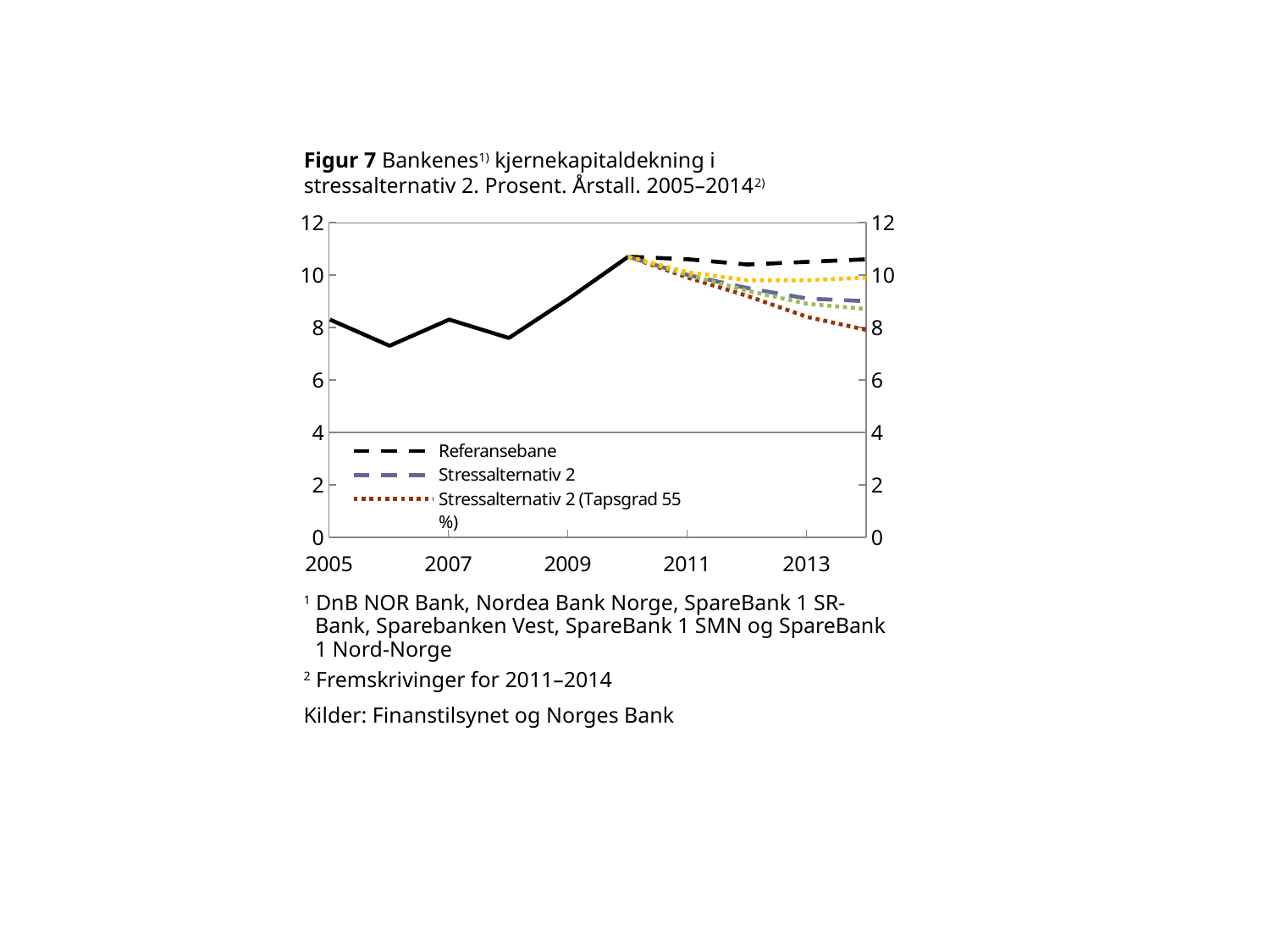
Which series has the lowest value in 2014? Stressalternativ 2 (Tapsgrad 55 %) In 2014, which is larger: Referansebane or Stressalternativ 2? Referansebane What is the highest value shown on the vertical axis? 12 Which series has the highest value in 2014? Referansebane Is the value in 2010 greater or less than 10? greater Is the value for Referansebane in 2014 greater or less than 10? greater What kind of chart is shown on the slide? line chart Does the Stressalternativ 2 (Tapsgrad 55 %) line rise or fall from 2010 to 2014? fall Does the line rise or fall from 2008 to 2010? rise Is the value for Stressalternativ 2 (Tapsgrad 55 %) in 2014 greater or less than 10? less How many series does the legend list? 3